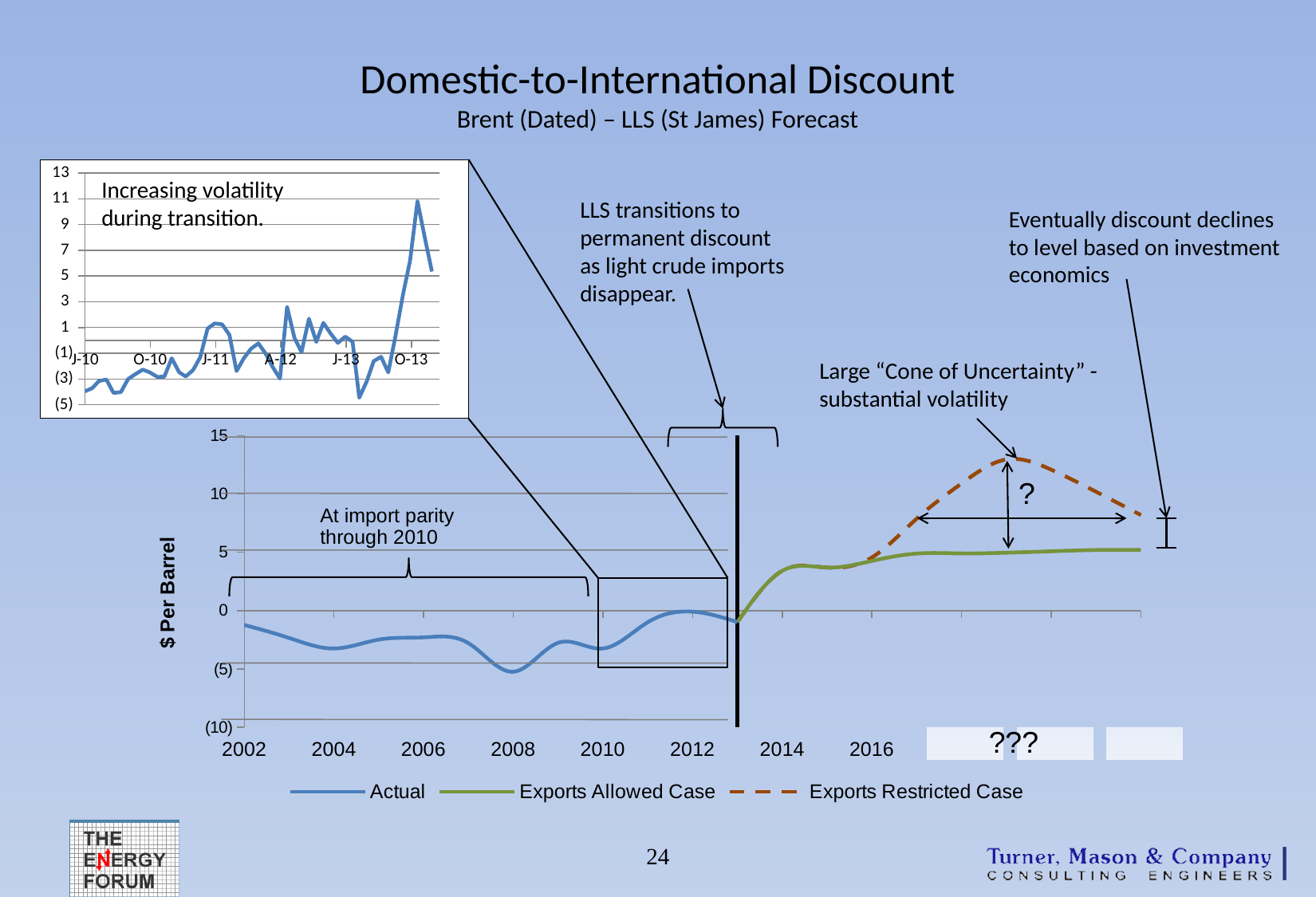
What kind of chart is the inset chart in the upper left of the slide? line chart In the main chart, is the peak of the Exports Restricted Case line greater or less than 10? greater In the inset chart, is the value at J-10 greater or less than 0? less How many series does the legend of the main chart list? 3 What is the y-axis label of the main chart? $ Per Barrel In the inset chart, is the highest value on the line greater or less than 9? greater How many year labels are shown on the x axis of the main chart? 8 What kind of chart is the main chart at the bottom of the slide? line chart In the main chart, which series reaches a higher value at the peak of the dashed line: Exports Restricted Case or Exports Allowed Case? Exports Restricted Case In the main chart, does the Exports Allowed Case line rise or fall from 2013 to 2016? rise